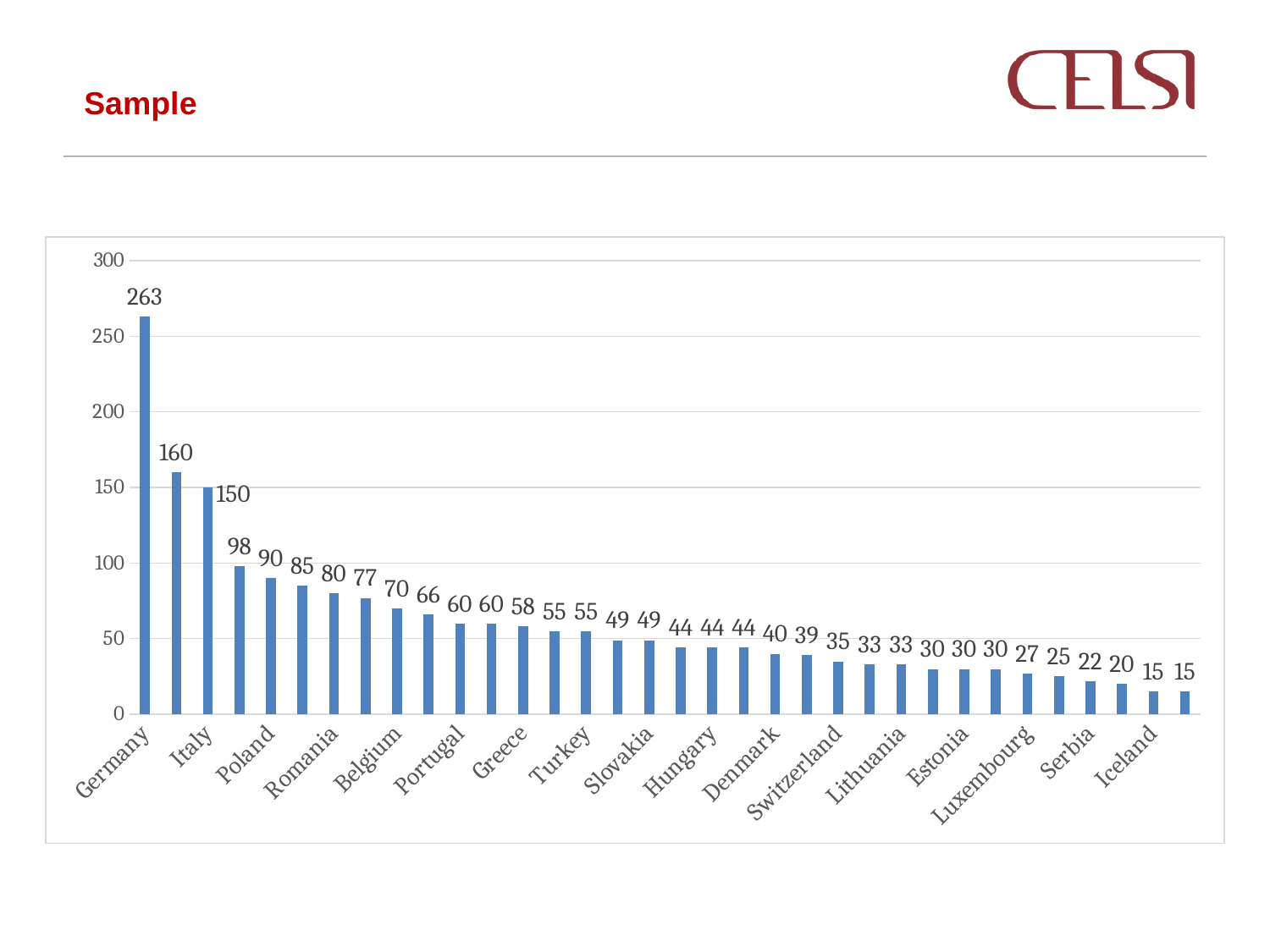
What is the value for Hungary? 44 Do the values rise or fall from left to right along the x axis? fall What type of chart is shown on the slide? bar chart Which of the labelled countries has the lowest value? Iceland What is the value for Turkey? 55 Which has a larger value, Germany or Italy? Germany What is the value for Germany? 263 Is the value for Poland greater or less than 100? less Which country has the highest value? Germany What is the value for Iceland? 15 What is the value for Estonia? 30 What is the difference between the values for Germany and Iceland? 248